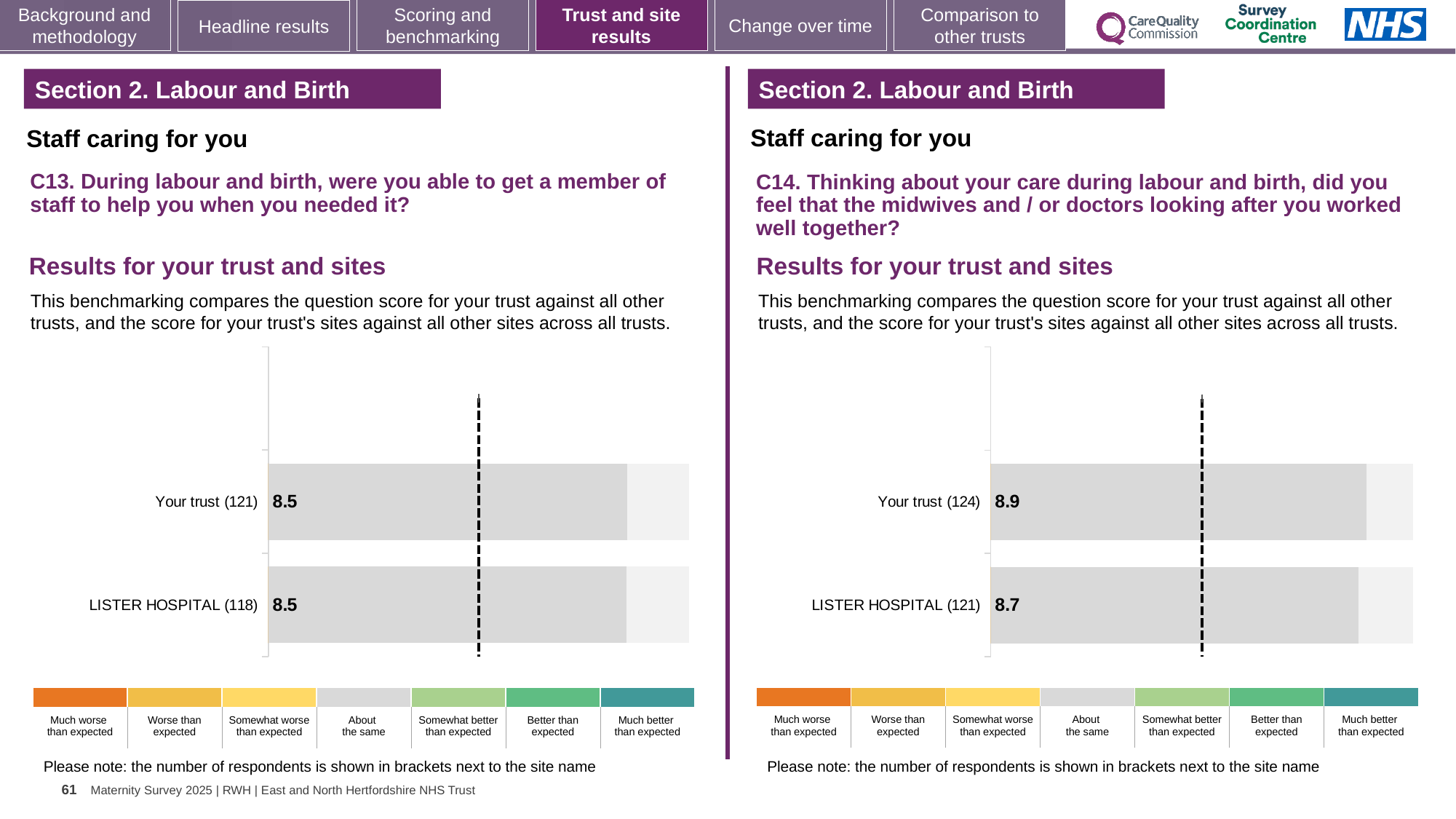
In the C14 chart on the right, how many respondents are shown in brackets for Your trust? 124 In the C14 chart on the right, what is the difference between the score for Your trust and the score for LISTER HOSPITAL? 0.2 In the C14 chart on the right, what is the score for Your trust (124)? 8.9 In the C14 chart on the right, which has the higher score, Your trust or LISTER HOSPITAL? Your trust In the C13 chart on the left, how many respondents are shown in brackets for LISTER HOSPITAL? 118 How many bars are plotted in the C14 chart on the right? 2 In the C13 chart on the left, what is the score for Your trust (121)? 8.5 In the C13 chart on the left, what is the score for LISTER HOSPITAL (118)? 8.5 How many bars are plotted in the C13 chart on the left? 2 In the C13 chart on the left, is the score for Your trust larger than, smaller than, or equal to the score for LISTER HOSPITAL? equal In the C14 chart on the right, what is the score for LISTER HOSPITAL (121)? 8.7 What type of chart is used for the C13 results on the left? Bar chart